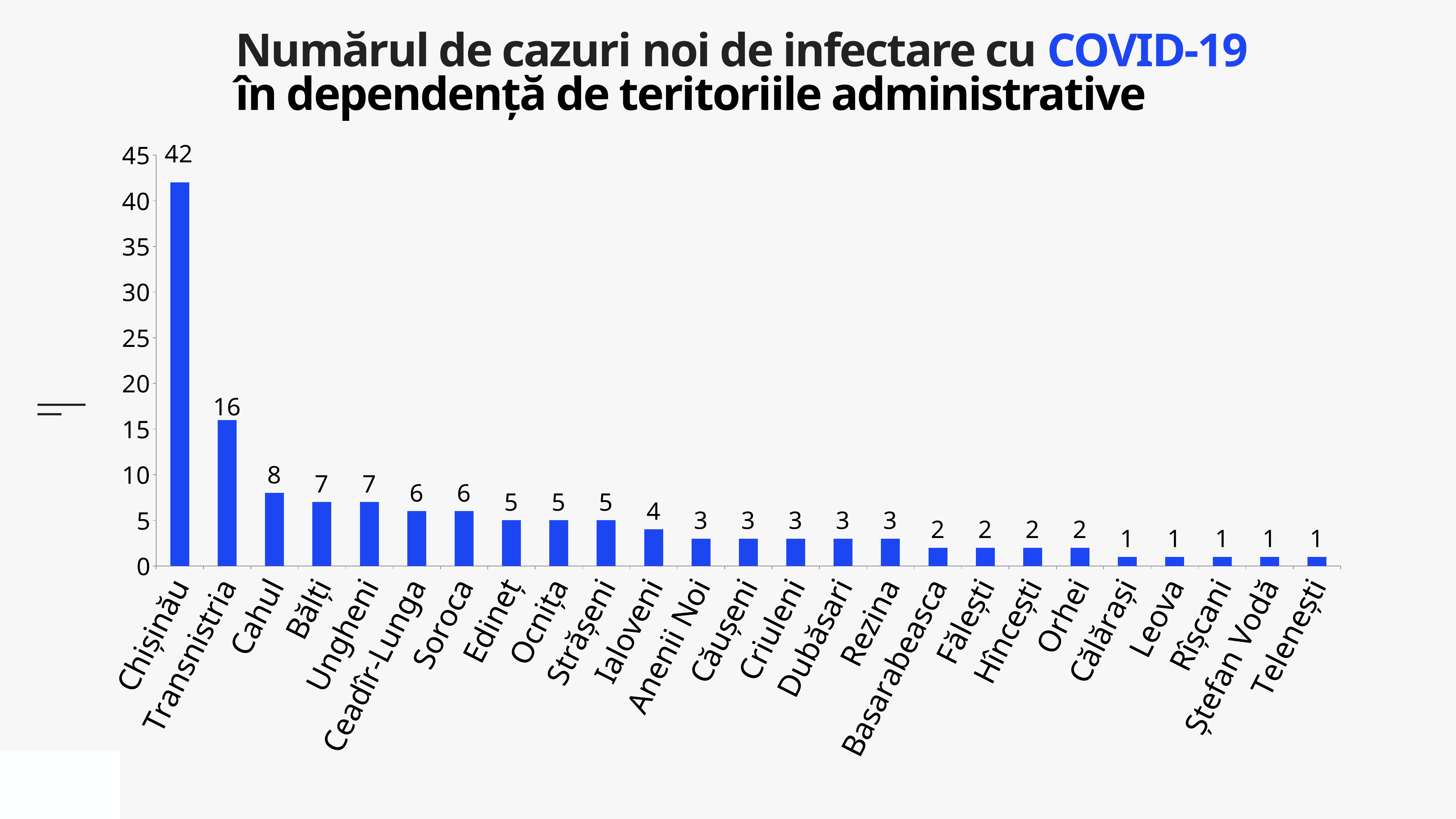
What is the value for Ialoveni? 4 Which is larger, the value for Soroca or the value for Orhei? Soroca What is the value for Transnistria? 16 Is the value for Chișinău greater or less than 40? greater What is the value for Chișinău? 42 What is the value for Basarabeasca? 2 Which category has the highest value? Chișinău What is the difference between the values for Cahul and Edineț? 3 What is the difference between the values for Chișinău and Transnistria? 26 Do the values rise or fall from left to right along the x axis? fall What kind of chart is shown on the slide? bar chart How many categories are shown on the x axis? 25